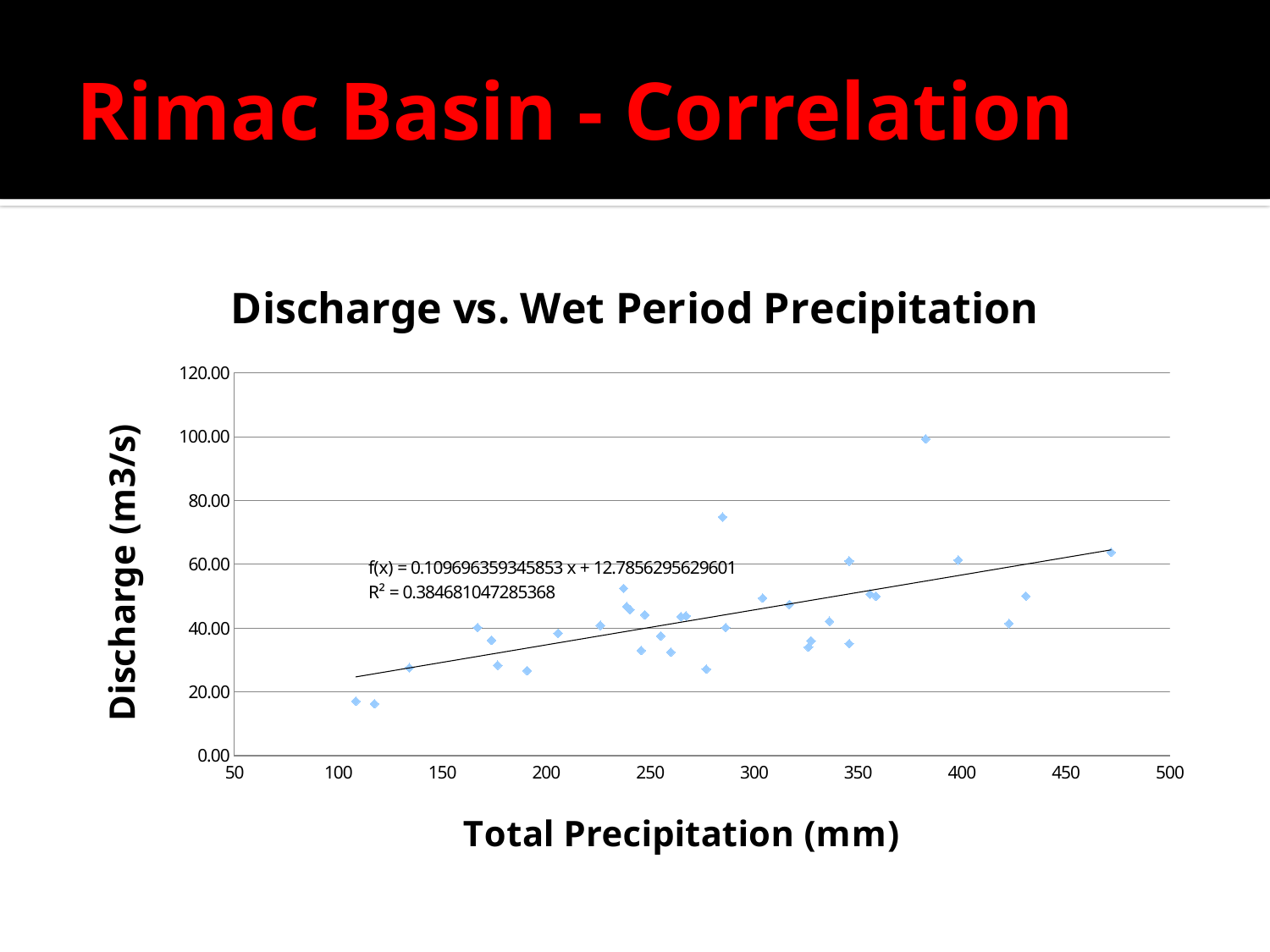
What kind of chart is shown on the slide? Scatter chart Is the discharge value of the highest point on the chart greater or less than 80.00? greater Is the slope of the fitted trendline positive or negative? Positive Is the discharge value of the lowest point on the chart greater or less than 20.00? less Is the discharge value of the point plotted near 190 mm of total precipitation greater or less than 40.00? less What is the title of the chart? Discharge vs. Wet Period Precipitation What R² value is printed on the chart? R² = 0.384681047285368 Does discharge tend to rise or fall as total precipitation increases along the x axis? Rise